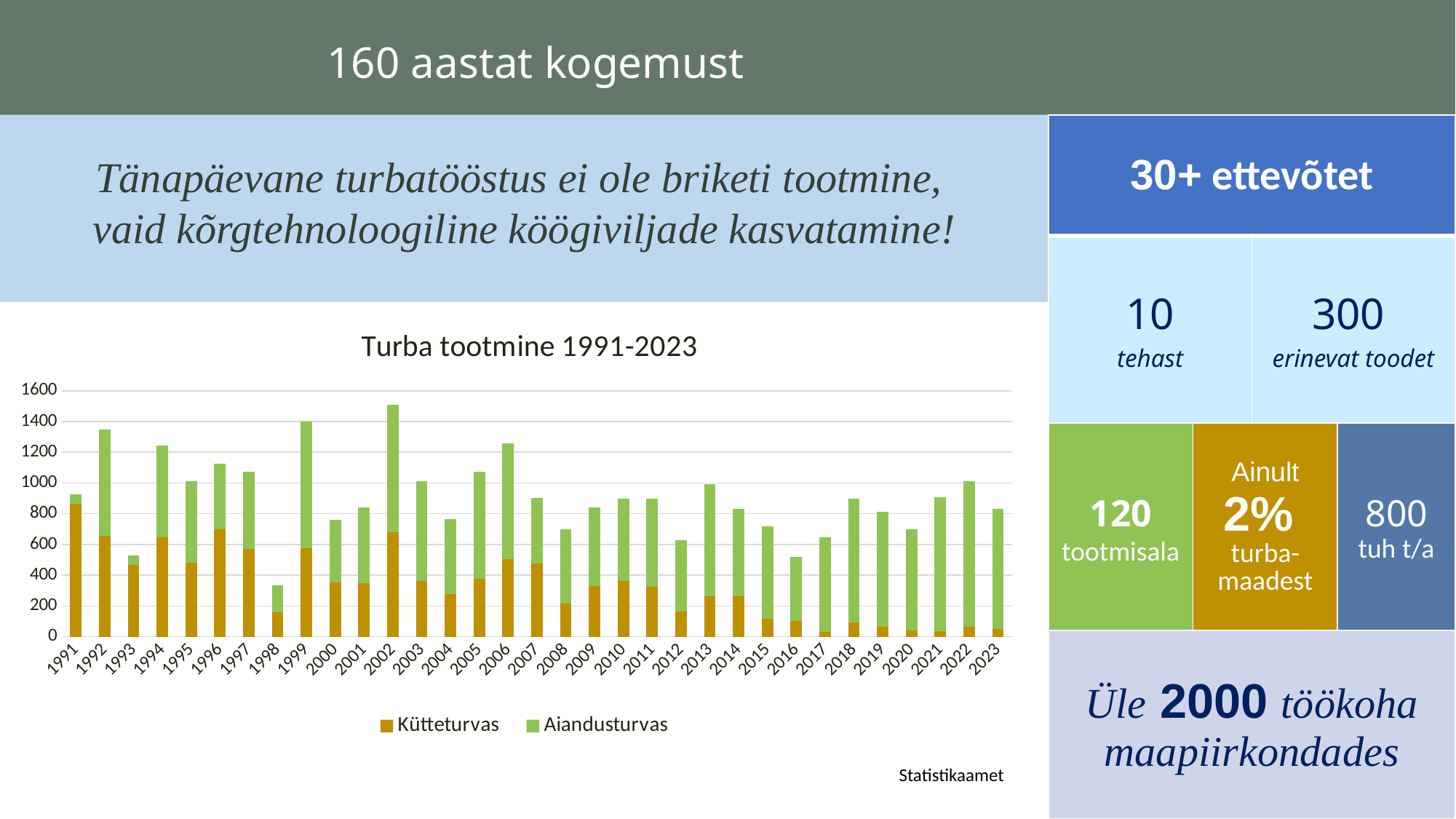
In the 'Turba tootmine 1991-2023' chart, which year has the larger total bar, 1992 or 1993? 1992 How many years are shown on the x axis of the 'Turba tootmine 1991-2023' chart? 33 What kind of chart is shown under the title 'Turba tootmine 1991-2023'? Stacked bar chart Which year has the lowest total bar in the 'Turba tootmine 1991-2023' chart? 1998 What are the two series named in the legend of the 'Turba tootmine 1991-2023' chart? Kütteturvas and Aiandusturvas In the 'Turba tootmine 1991-2023' chart, does the Kütteturvas series generally rise or fall from 1991 to 2023? fall Is the total value for 1998 in the 'Turba tootmine 1991-2023' chart greater or less than 400? less Is the Kütteturvas value for 1991 in the 'Turba tootmine 1991-2023' chart greater or less than 800? greater Is the total value for 2016 in the 'Turba tootmine 1991-2023' chart greater or less than 600? less Which year has the highest total bar in the 'Turba tootmine 1991-2023' chart? 2002 How many series does the legend of the 'Turba tootmine 1991-2023' chart list? 2